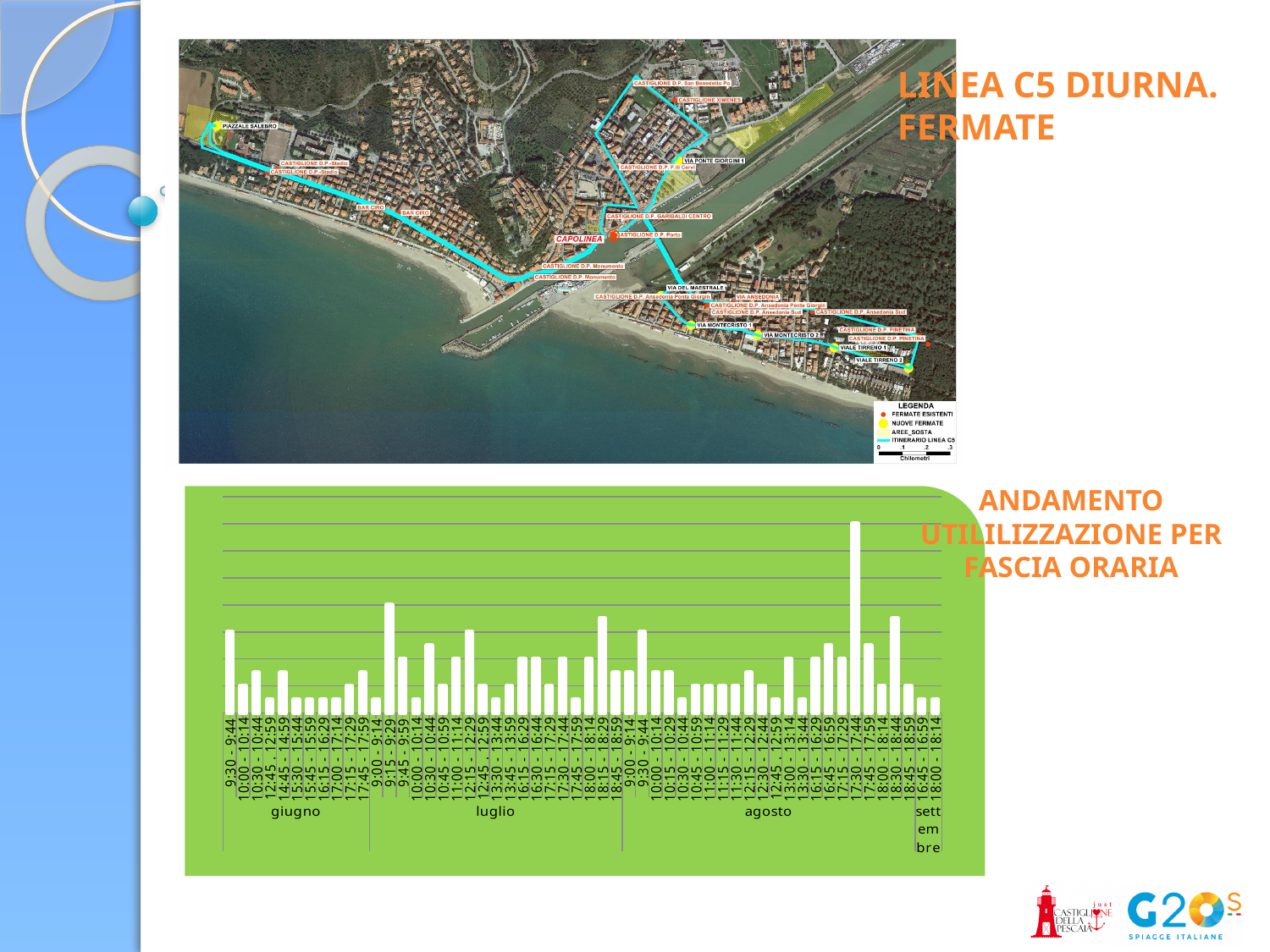
What is the title of the bar chart on the slide? ANDAMENTO UTILILIZZAZIONE PER FASCIA ORARIA In the bar chart, which is taller: the bar for 9:30 - 9:44 in giugno or the bar for 10:00 - 10:14 in giugno? 9:30 - 9:44 in giugno In the bar chart, which is taller: the bar for 9:15 - 9:29 in luglio or the bar for 17:30 - 17:44 in agosto? 17:30 - 17:44 in agosto Which month group in the bar chart has the fewest bars? settembre How many month groups are shown along the x axis of the bar chart? 4 In the bar chart, which month group contains the tallest bar? agosto What kind of chart is the 'ANDAMENTO UTILILIZZAZIONE PER FASCIA ORARIA' chart? bar chart In the bar chart, which is taller: the bar for 9:30 - 9:44 in giugno or the bar for 9:15 - 9:29 in luglio? 9:15 - 9:29 in luglio In the bar chart, which time slot has the tallest bar overall? 17:30 - 17:44 (agosto) Which month groups are labelled along the x axis of the bar chart? giugno, luglio, agosto, settembre